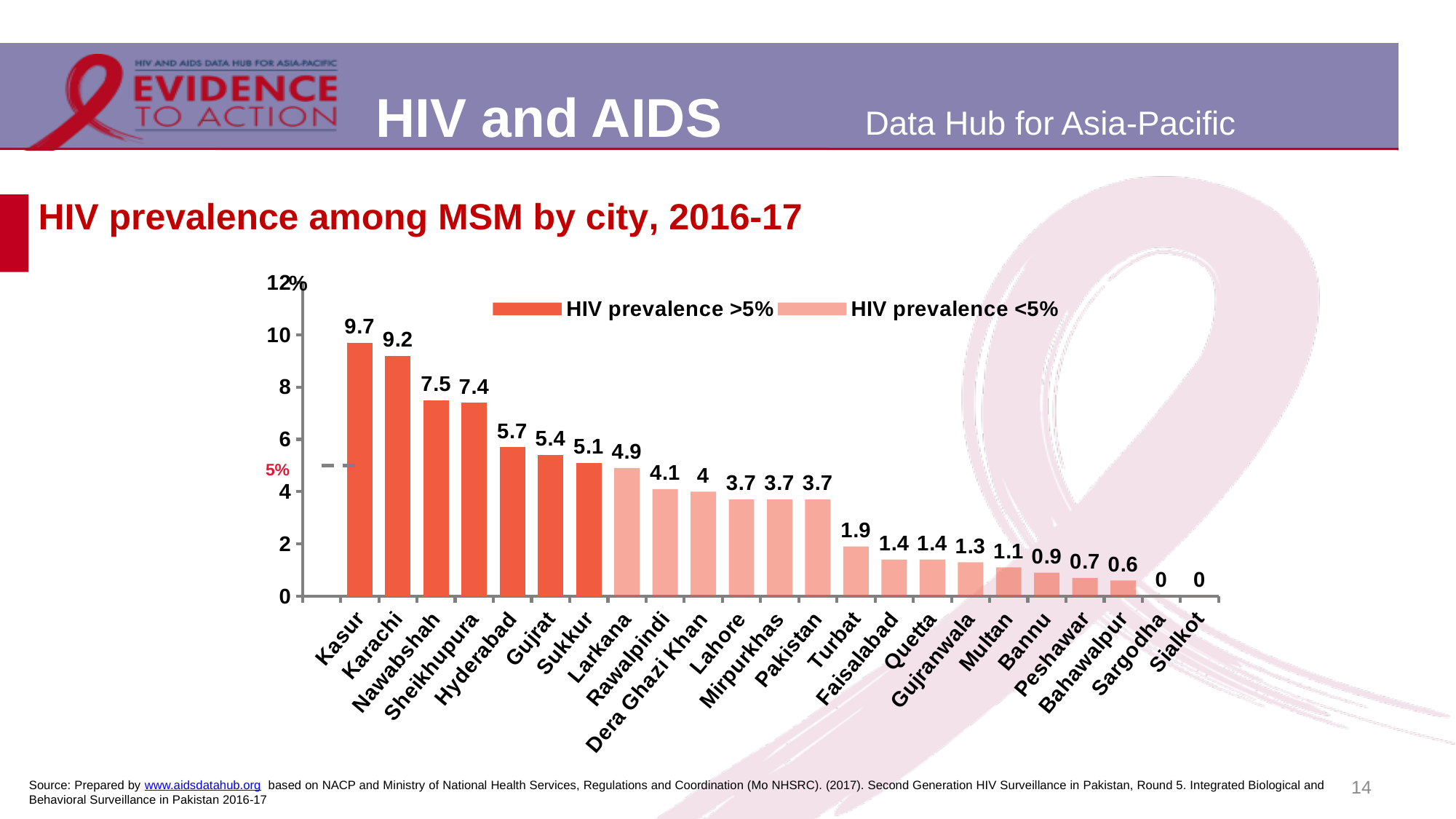
Which city has the highest HIV prevalence among MSM? Kasur Do the values rise or fall moving from left to right along the x axis? Fall What is the difference between the values for Kasur and Karachi? 0.5 How many series does the legend list? 2 Is the value for Sheikhupura greater or less than 6? greater How many cities/categories are shown on the x axis? 23 What is the value shown for Pakistan overall? 3.7 What is the HIV prevalence among MSM in Karachi? 9.2 What is the HIV prevalence among MSM in Hyderabad? 5.7 What kind of chart is shown on the slide? Bar chart What is the difference between the values for Larkana and Turbat? 3 Which has a higher HIV prevalence, Nawabshah or Sukkur? Nawabshah